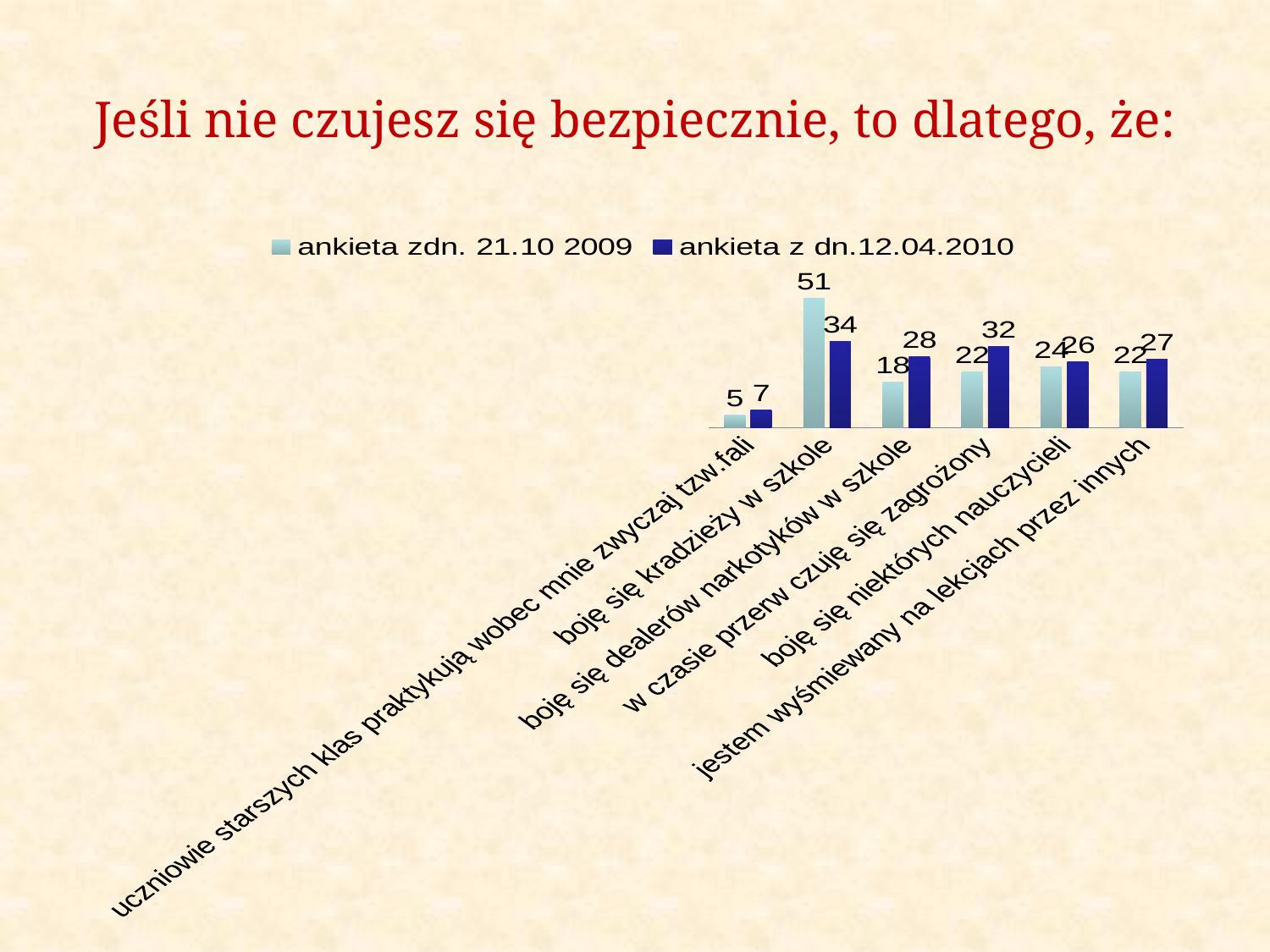
What is the difference between the two series for "w czasie przerw czuję się zagrożony"? 10 Which category has the lowest value in the "ankieta z dn.12.04.2010" series? uczniowie starszych klas praktykują wobec mnie zwyczaj tzw.fali What is the value for "boję się dealerów narkotyków w szkole" in the "ankieta z dn.12.04.2010" series? 28 How many series does the legend list? 2 Which category has the highest value in the "ankieta zdn. 21.10 2009" series? boję się kradzieży w szkole What is the value for "boję się kradzieży w szkole" in the "ankieta zdn. 21.10 2009" series? 51 What kind of chart is shown on the slide? bar chart What is the difference between the two series for "boję się kradzieży w szkole"? 17 What is the value for "uczniowie starszych klas praktykują wobec mnie zwyczaj tzw.fali" in the "ankieta z dn.12.04.2010" series? 7 What is the title of the slide above the chart? Jeśli nie czujesz się bezpiecznie, to dlatego, że: How many categories are shown on the x axis? 6 For "jestem wyśmiewany na lekcjach przez innych", which series has the larger value? ankieta z dn.12.04.2010